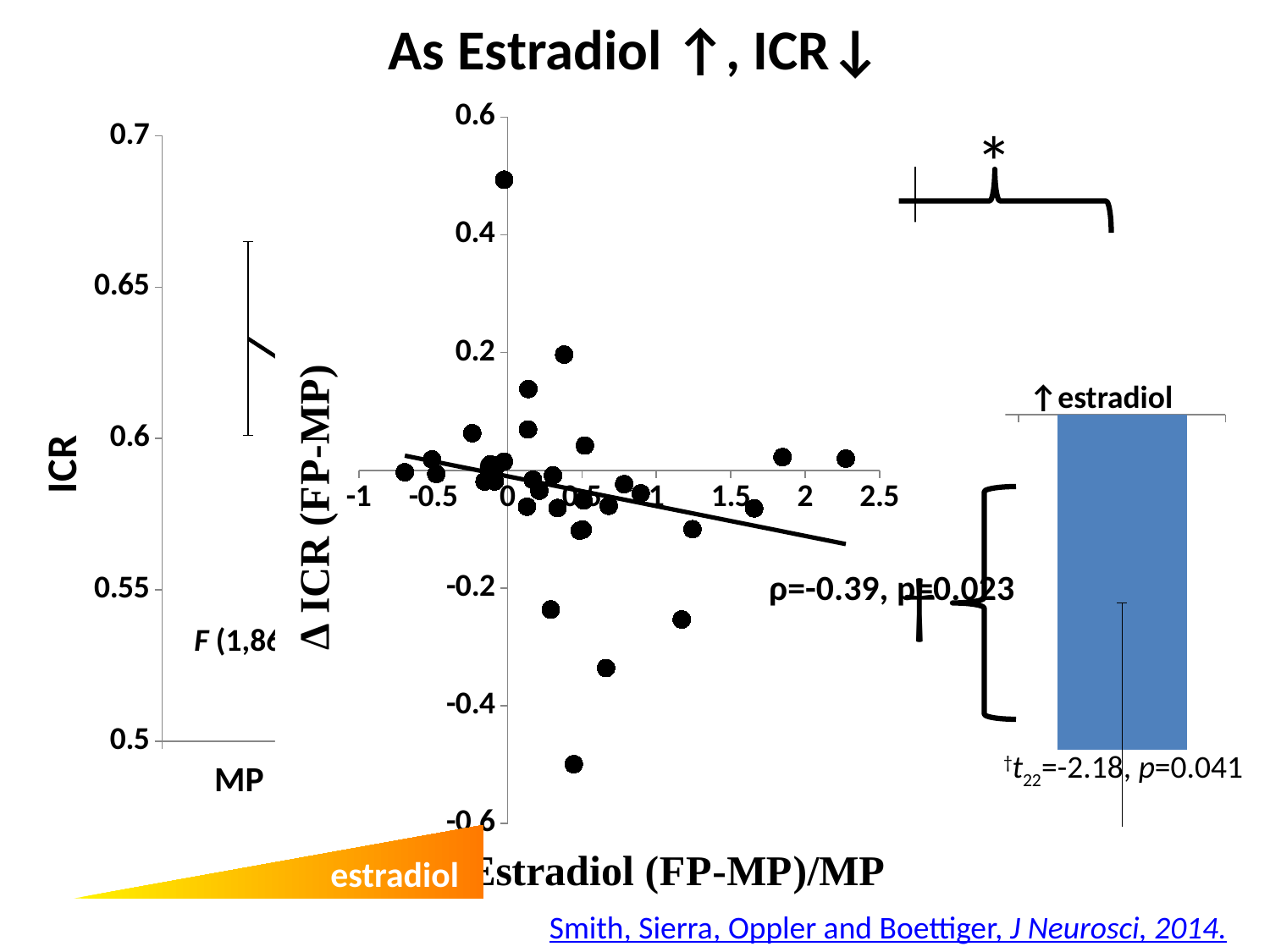
What statistic is printed beneath the bar chart on the right? †t22=-2.18, p=0.041 In the middle scatter plot, what correlation coefficient and p-value are printed on the chart? ρ=-0.39, p=0.023 In the middle scatter plot, is the lowest plotted point greater or less than -0.4 on the Δ ICR (FP-MP) axis? less What kind of chart is the middle chart with the y axis labelled Δ ICR (FP-MP)? scatter plot In the chart on the right, does the ↑estradiol bar extend upward or downward from the baseline? downward In the left chart with the y axis labelled ICR, is the value plotted at MP greater or less than 0.65? less In the middle scatter plot, is the highest plotted point greater or less than 0.4 on the Δ ICR (FP-MP) axis? greater What kind of chart is the chart on the right labelled ↑estradiol? bar chart How many bars does the chart on the right labelled ↑estradiol contain? 1 In the middle scatter plot, does the fitted line rise or fall as Estradiol (FP-MP)/MP increases along the x axis? fall In the middle scatter plot, what is the label of the x axis? Estradiol (FP-MP)/MP